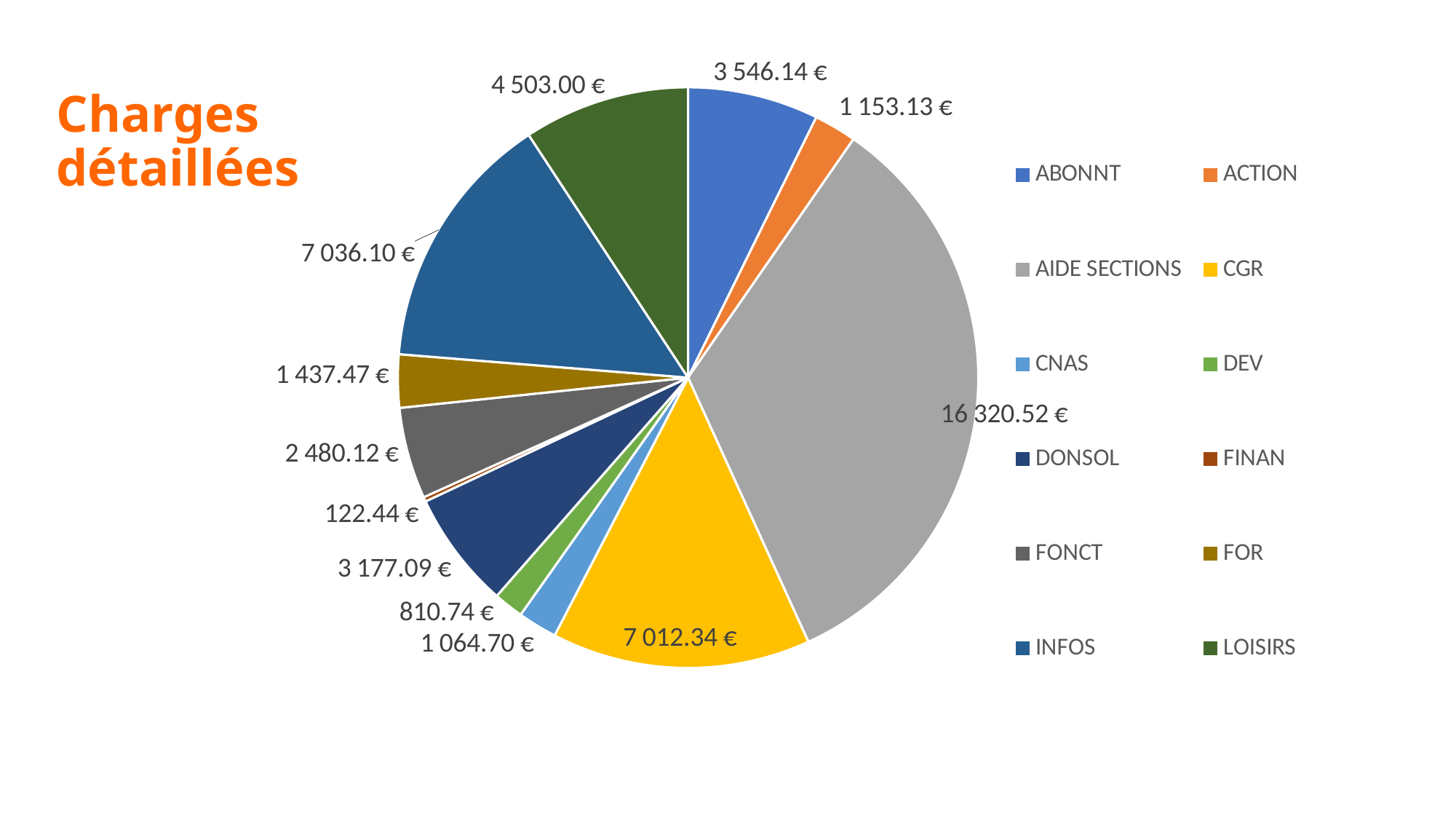
What type of chart is shown on the slide? pie chart How many categories does the legend list? 12 What is the value for FINAN? 122.44 € Which category has the largest slice? AIDE SECTIONS What is the difference between the values for INFOS and CGR? 23.76 € Which category has the smallest slice? FINAN What is the title of the chart? Charges détaillées What is the value for AIDE SECTIONS? 16 320.52 € What is the value for LOISIRS? 4 503.00 € What is the value for CGR? 7 012.34 € Which is larger, LOISIRS or ABONNT? LOISIRS What is the difference between the values for LOISIRS and ABONNT? 956.86 €